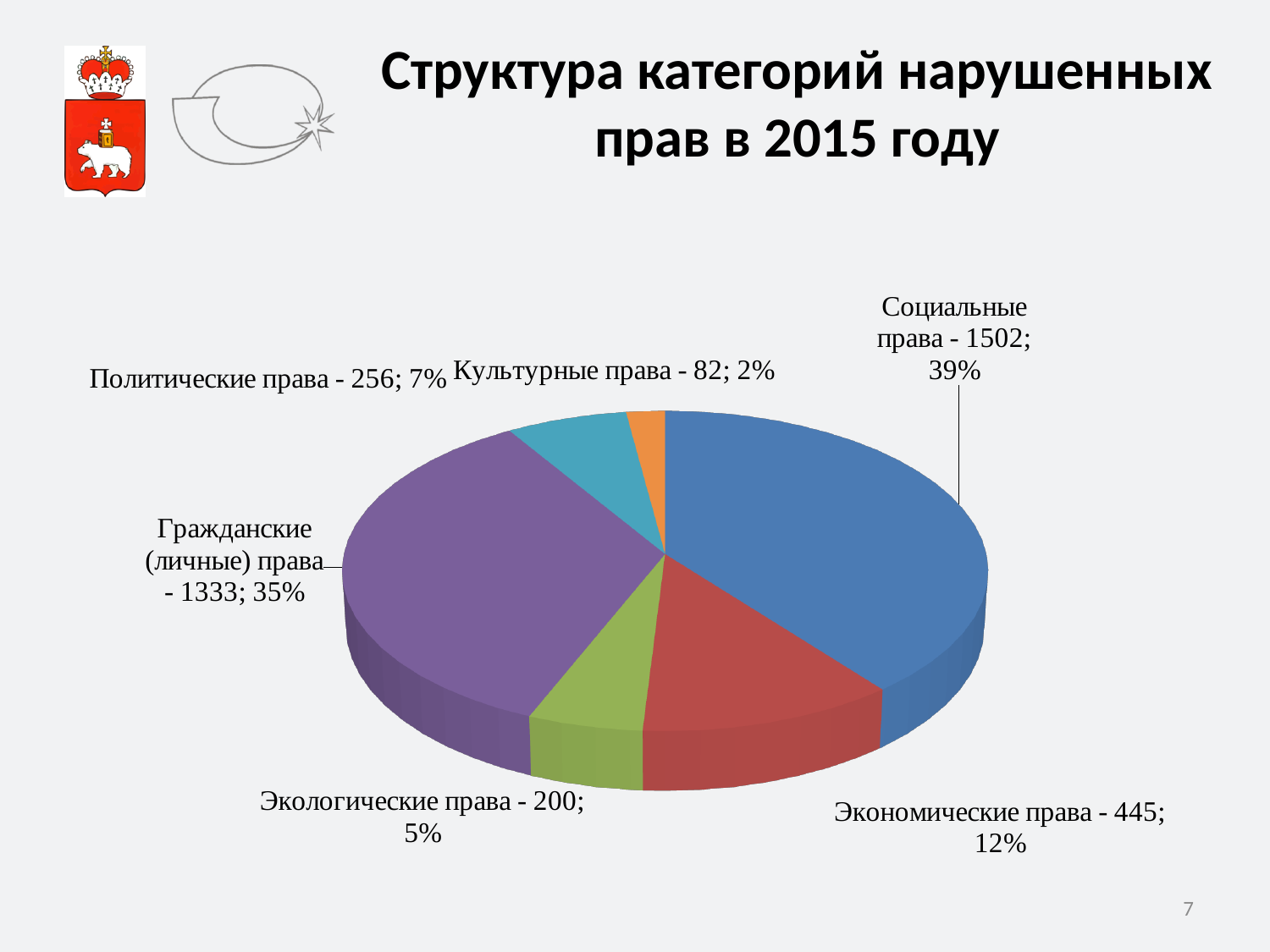
What is the value for Экономические права? 445 How many categories does the pie chart show? 6 What type of chart is shown on the slide? pie chart Which category has the largest share of the pie? Социальные права What is the value for Гражданские (личные) права? 1333 Which is larger, the value for Политические права or the value for Экологические права? Политические права What is the value for Социальные права? 1502 What share of the pie does Экологические права represent? 5% What share of the pie does Гражданские (личные) права represent? 35% What is the value for Культурные права? 82 What is the difference between the values for Социальные права and Гражданские (личные) права? 169 Which category has the smallest share of the pie? Культурные права